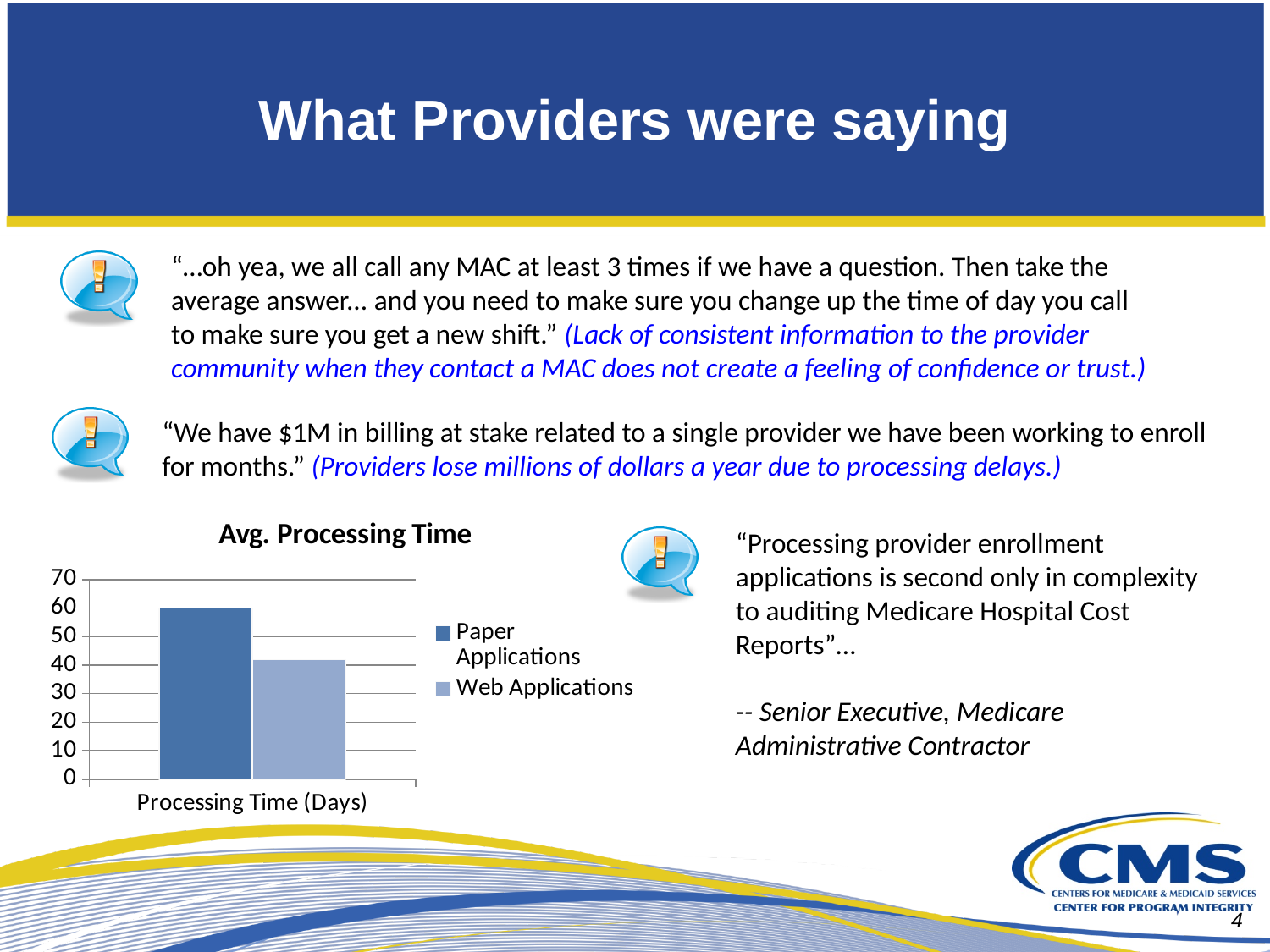
In the "Avg. Processing Time" chart, is the value for Paper Applications greater or less than 50? greater How many series does the legend of the "Avg. Processing Time" chart list? 2 In the "Avg. Processing Time" chart, is the value for Paper Applications larger or smaller than the value for Web Applications? larger In the "Avg. Processing Time" chart, is the value for Web Applications greater or less than 30? greater Which series has the taller bar in the "Avg. Processing Time" chart? Paper Applications What kind of chart is shown under the title "Avg. Processing Time"? bar chart What is the category label on the x axis of the "Avg. Processing Time" chart? Processing Time (Days) In the "Avg. Processing Time" chart, is the value for Web Applications greater or less than 50? less Which series has the shorter bar in the "Avg. Processing Time" chart? Web Applications How many categories are shown on the x axis of the "Avg. Processing Time" chart? 1 What are the two series named in the legend of the "Avg. Processing Time" chart? Paper Applications and Web Applications